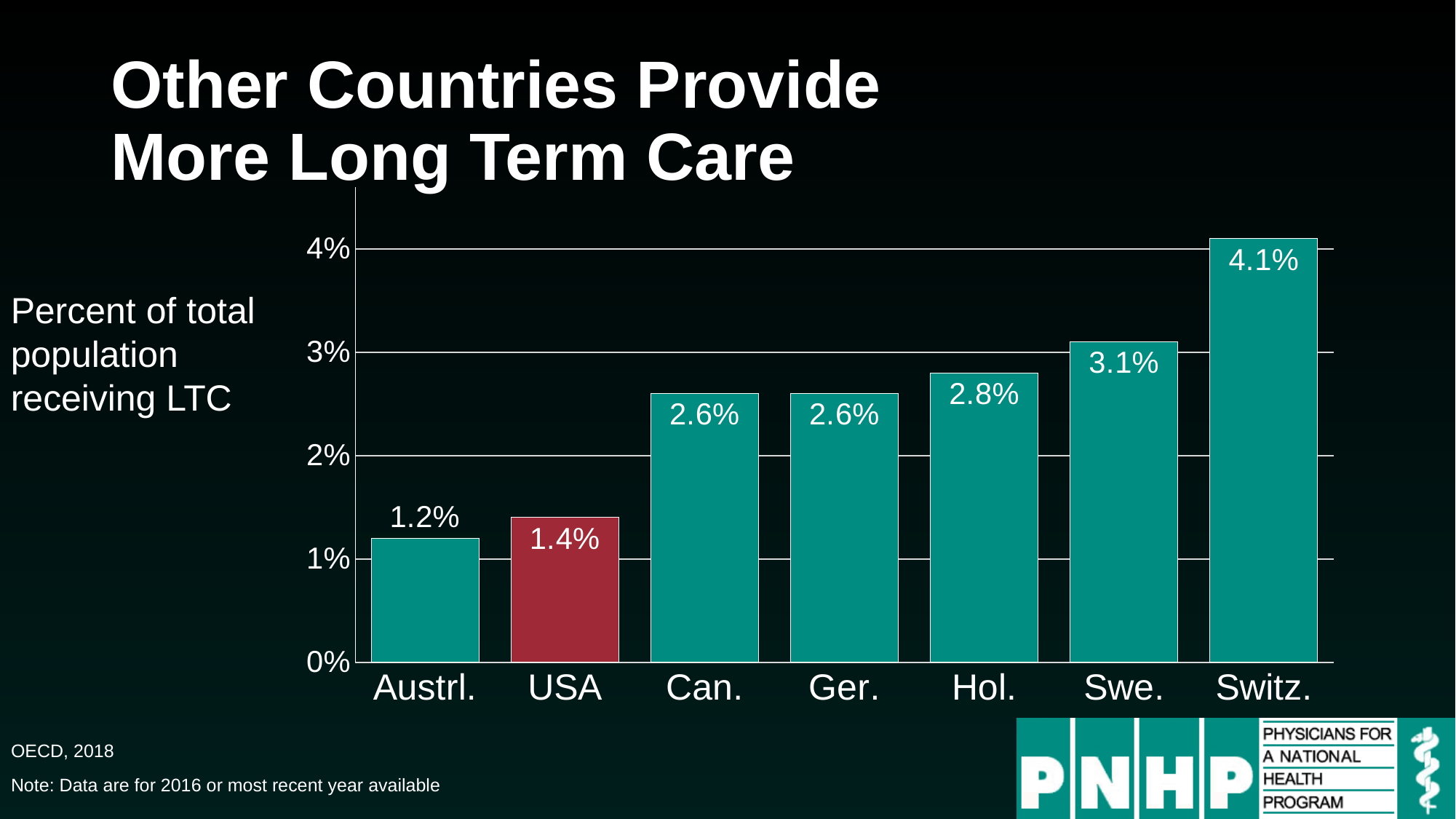
What is the value for Switz.? 4.1% What kind of chart is shown on the slide? bar chart How many countries are shown in the chart? 7 Which bar is coloured differently (red) from the others? USA Which is larger, the value for Swe. or the value for Ger.? Swe. Which country has the highest value? Switz. Which country has the lowest value? Austrl. Is the value for Can. greater or less than 2%? greater What is the value for Hol.? 2.8% What is the value for USA? 1.4% What is the difference between the values for Swe. and Hol.? 0.3% What is the difference between the values for Switz. and USA? 2.7%